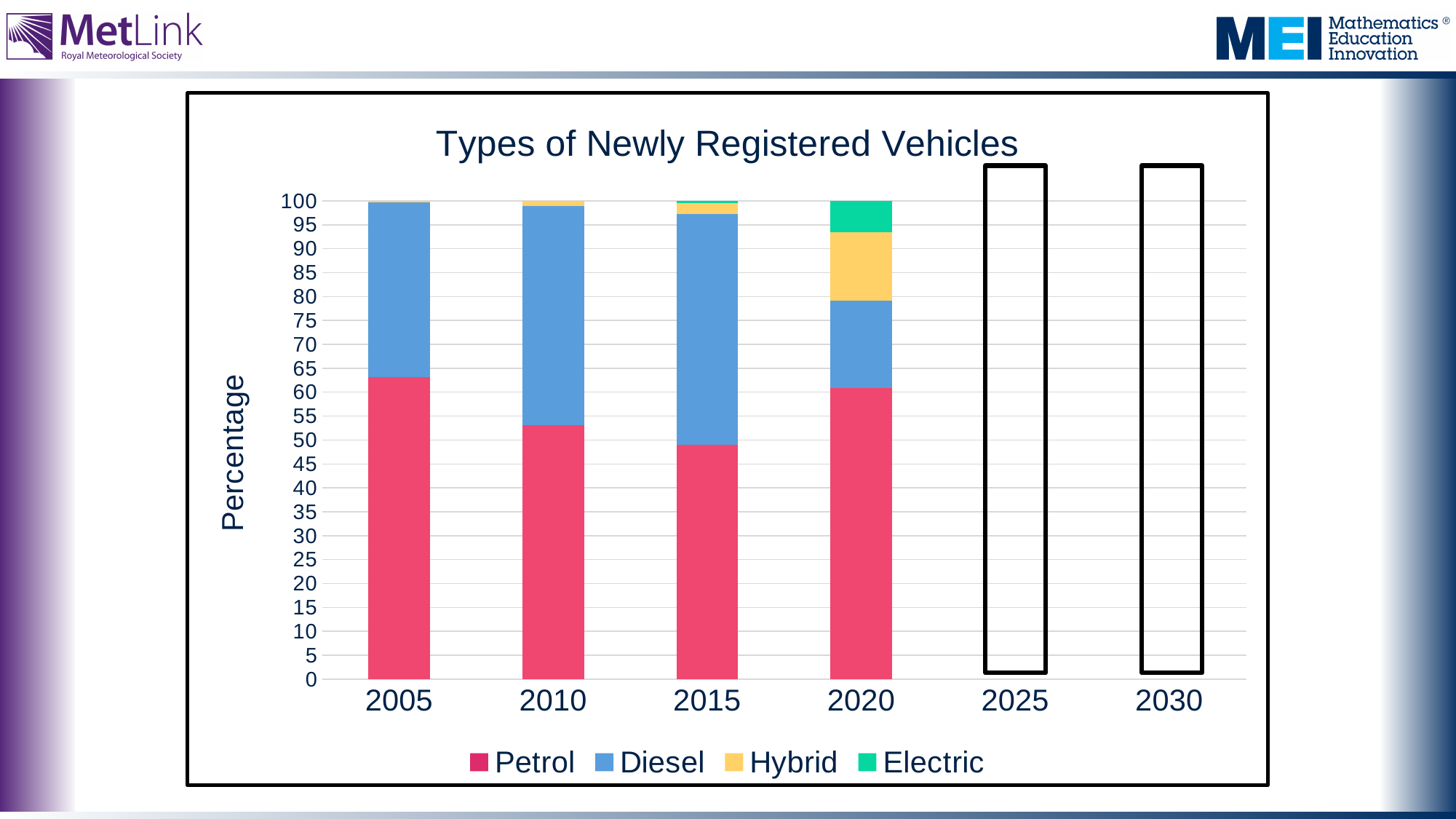
Which year has the smallest Petrol share? 2015 Is the Petrol share in 2005 greater or less than 60? greater How many years on the x axis have plotted data bars? 4 Does the Petrol share rise or fall from 2005 to 2015? fall Is the Petrol share in 2010 greater or less than 50? greater Which year has the largest Petrol share? 2005 Is the Electric share in 2020 greater or less than 10? less What kind of chart is shown on the slide? Stacked bar chart What is the title of the chart? Types of Newly Registered Vehicles How many series does the legend list? 4 Which year has the largest Electric share? 2020